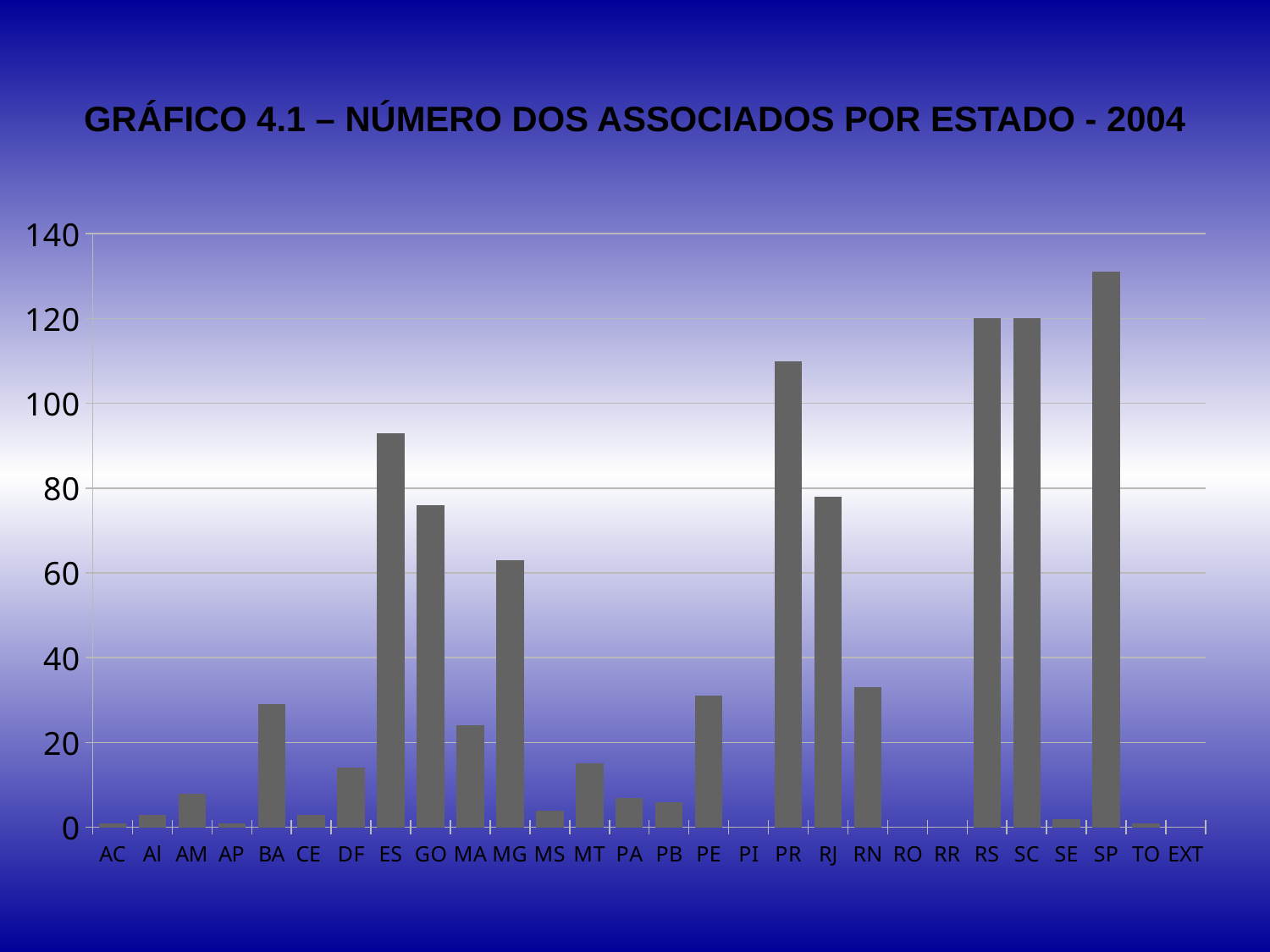
Is the value for ES greater or less than 80? greater What is the value for RS? 120 Is the value for PR greater or less than 100? greater Which is larger, the value for SP or the value for RS? SP Which is larger, the value for PR or the value for RJ? PR Is the value for DF greater or less than 20? less What kind of chart is shown on the slide? bar chart Which state has the highest number of associates? SP What is the title of the chart? GRÁFICO 4.1 – NÚMERO DOS ASSOCIADOS POR ESTADO - 2004 Which is larger, the value for ES or the value for GO? ES How many categories are shown on the x axis? 28